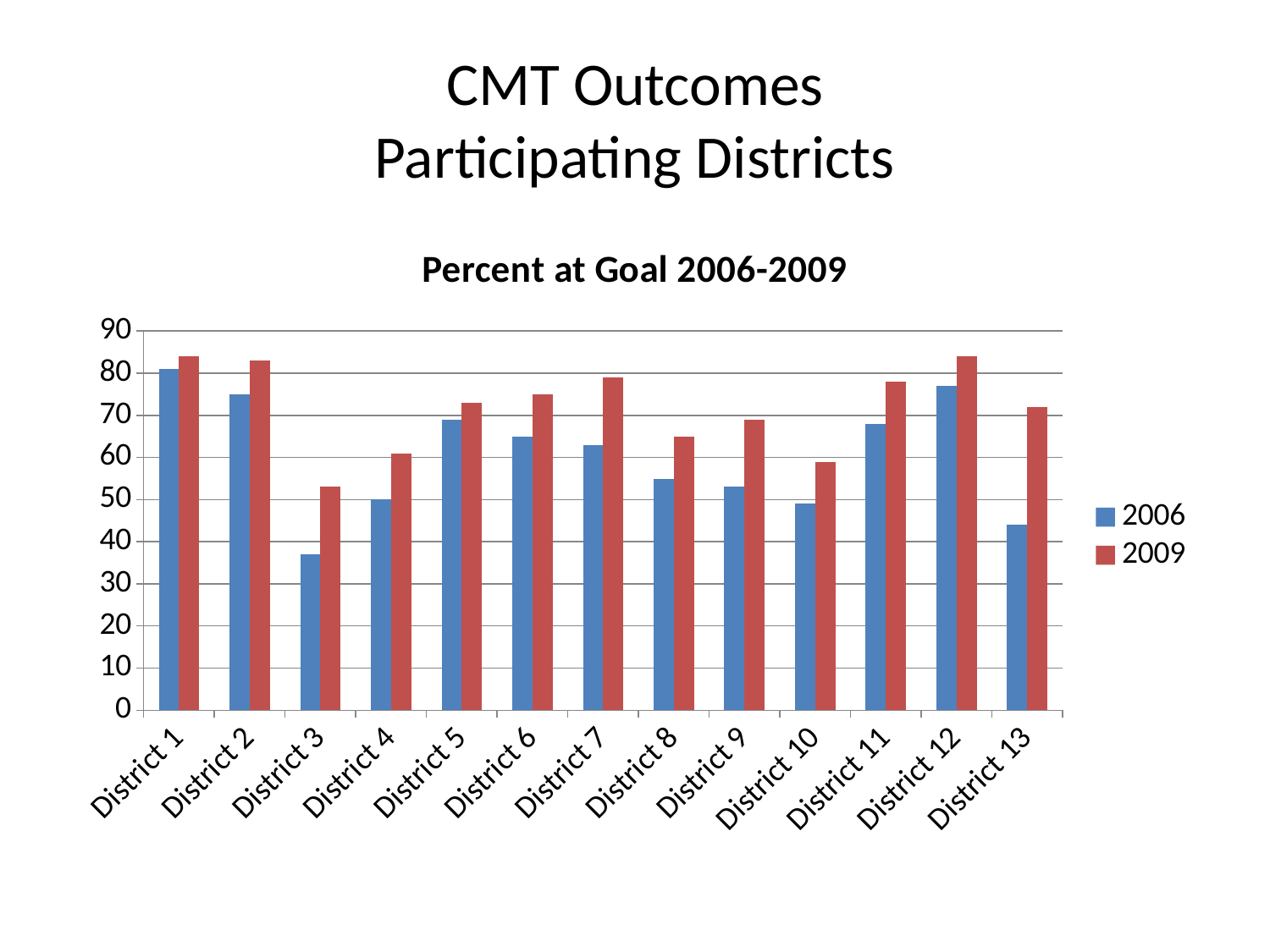
Which district has the highest 2006 value? District 1 Which district has the lowest 2006 value? District 3 Which years are listed in the chart's legend? 2006 and 2009 How many series does the chart's legend list? 2 Which is larger, the 2006 value for District 2 or the 2006 value for District 5? District 2 What is the title of the chart? Percent at Goal 2006-2009 Is the 2009 value for District 12 greater or less than 80? greater In each district, is the 2009 value higher or lower than the 2006 value? higher How many districts are shown on the x axis of the chart? 13 Is the 2006 value for District 3 greater or less than 40? less What kind of chart is shown on the slide? bar chart Which district has the lowest 2009 value? District 3